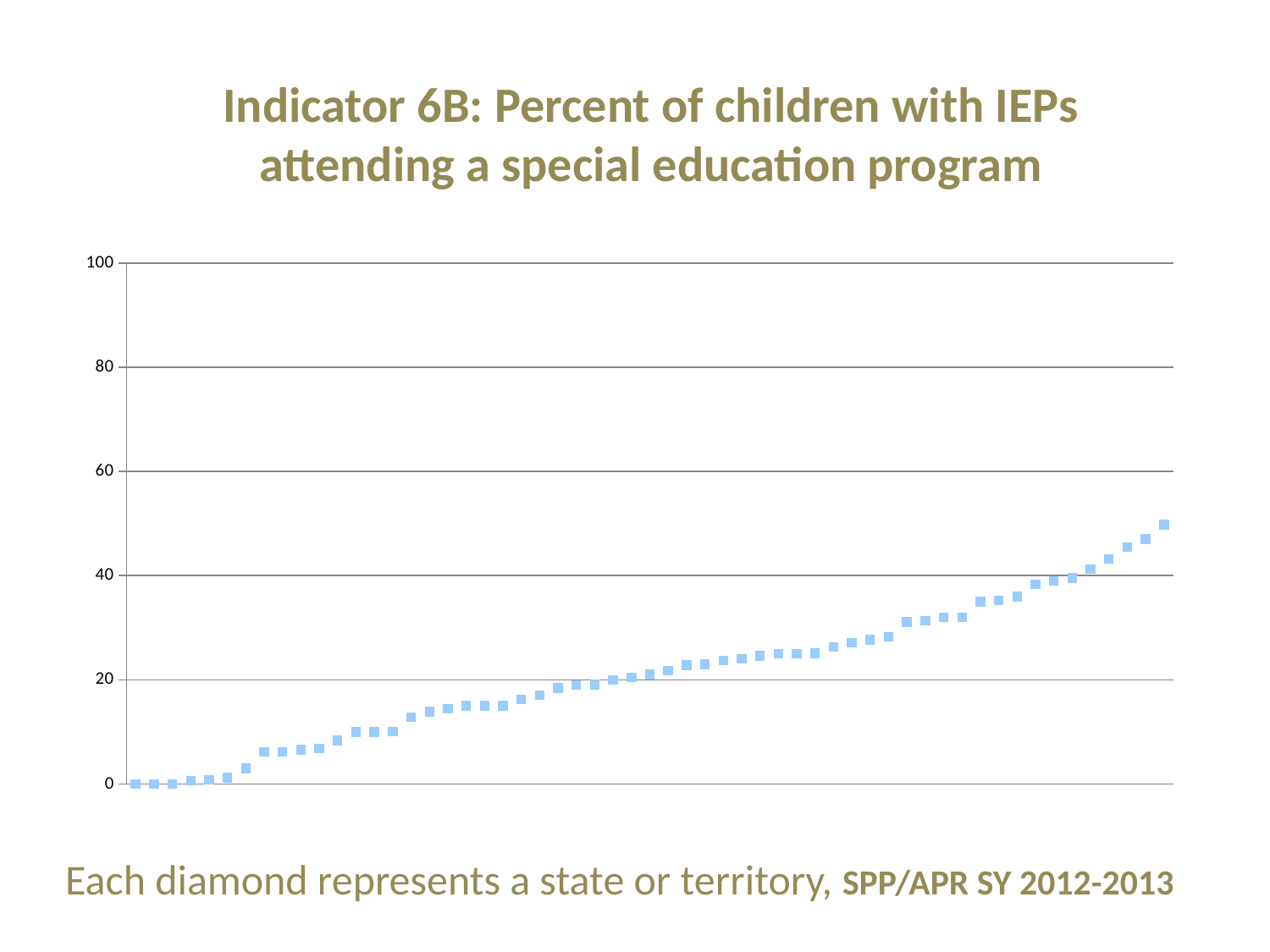
Is the highest plotted value greater or less than 40? greater According to the slide, what does each marker on the chart represent? a state or territory What is the lowest plotted value on the chart? 0 What is the title of the chart? Indicator 6B: Percent of children with IEPs attending a special education program What kind of chart is shown on the slide? scatter chart Do the plotted values rise or fall from left to right along the x axis? rise Is the lowest plotted value greater or less than 20? less Is the highest plotted value greater or less than 60? less